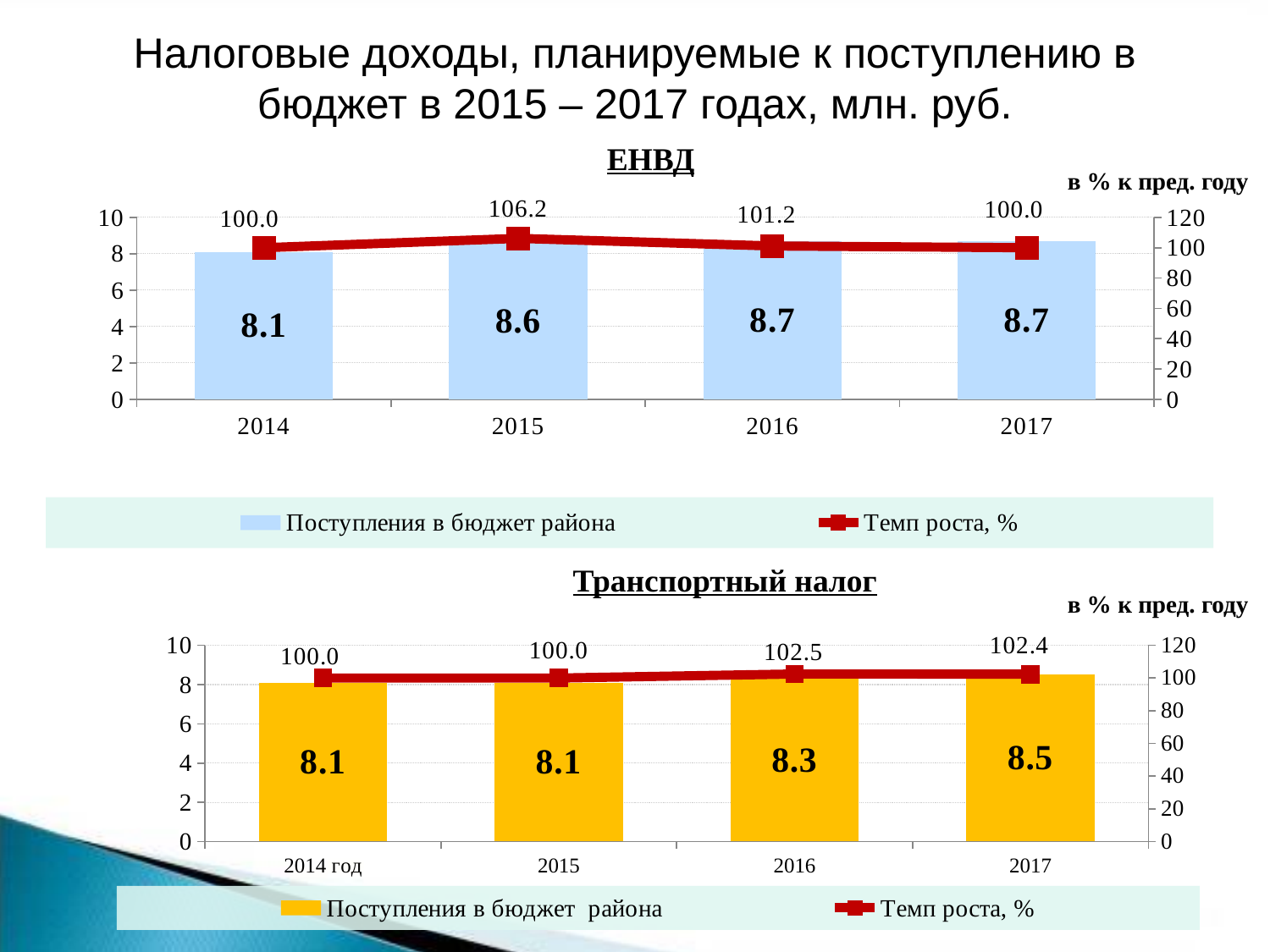
In the Транспортный налог chart, do the Поступления в бюджет района values rise or fall from 2014 to 2017? rise In the ЕНВД chart, what is the Темп роста, % value for 2015? 106.2 How many years are shown on the x axis of the ЕНВД chart? 4 How many series does the legend of the Транспортный налог chart list? 2 In the ЕНВД chart, what is the value of Поступления в бюджет района for 2015? 8.6 In the ЕНВД chart, what is the difference between the Поступления в бюджет района values for 2016 and 2014? 0.6 In the Транспортный налог chart, what is the difference between the Поступления в бюджет района values for 2017 and 2015? 0.4 In the ЕНВД chart, which year has the highest Темп роста, % value? 2015 In the Транспортный налог chart, what is the Темп роста, % value for 2016? 102.5 In the Транспортный налог chart, what is the value of Поступления в бюджет района for 2017? 8.5 In the Транспортный налог chart, which year has the highest Поступления в бюджет района value? 2017 In the ЕНВД chart, which year has the lowest Поступления в бюджет района value? 2014